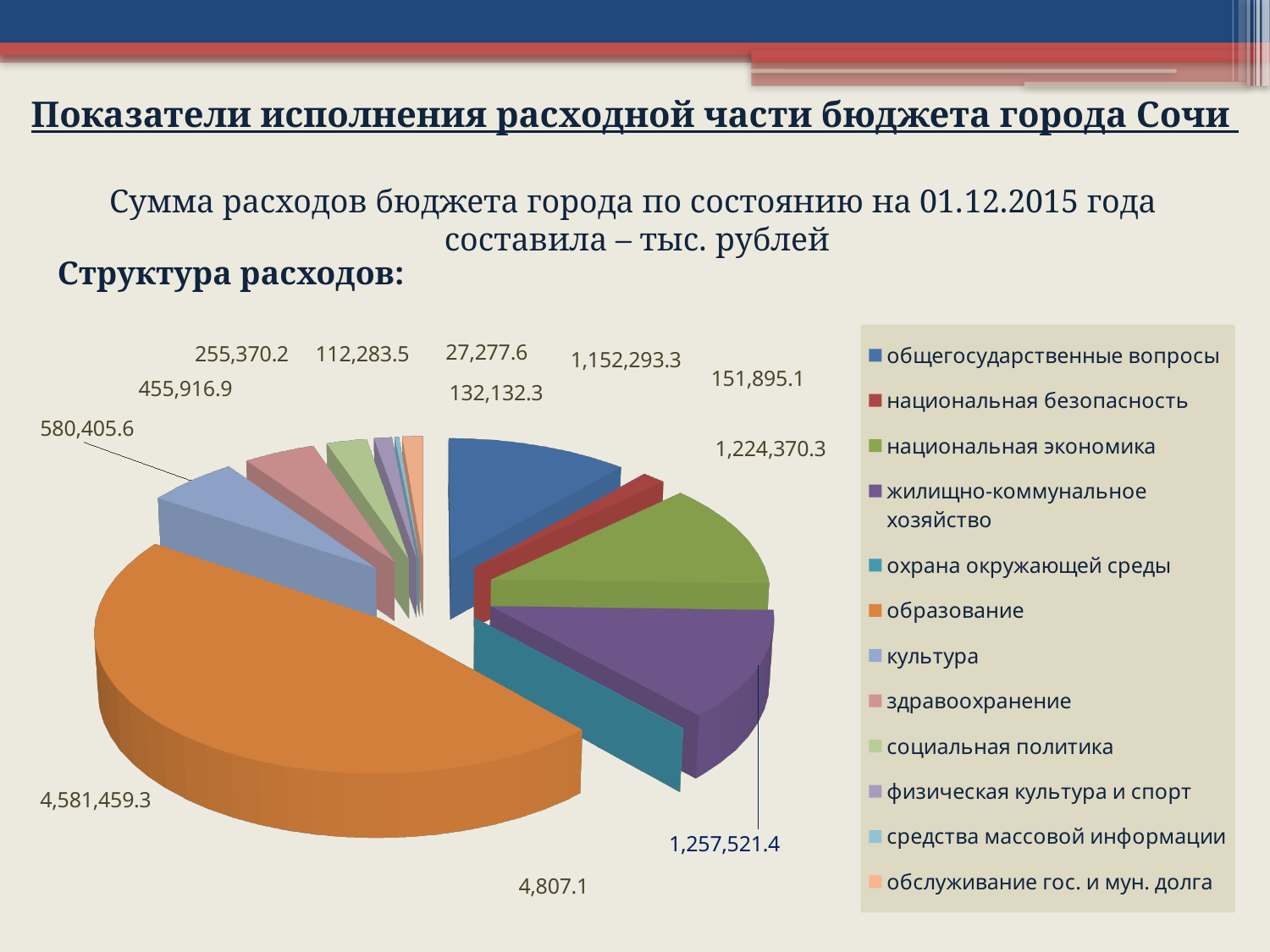
What heading appears above the pie chart? Структура расходов: What is the value shown for охрана окружающей среды? 4,807.1 What is the value shown for образование? 4,581,459.3 What is the value shown for жилищно-коммунальное хозяйство? 1,257,521.4 Which category has the largest slice in the pie chart? образование What is the difference between the values for образование and жилищно-коммунальное хозяйство? 3,323,937.9 How many categories does the legend of the pie chart list? 12 Which category has the smallest value in the pie chart? охрана окружающей среды What is the value shown for культура? 580,405.6 What kind of chart is shown on the slide? pie chart Which is larger: образование or общегосударственные вопросы? образование What colour is the slice for образование? orange